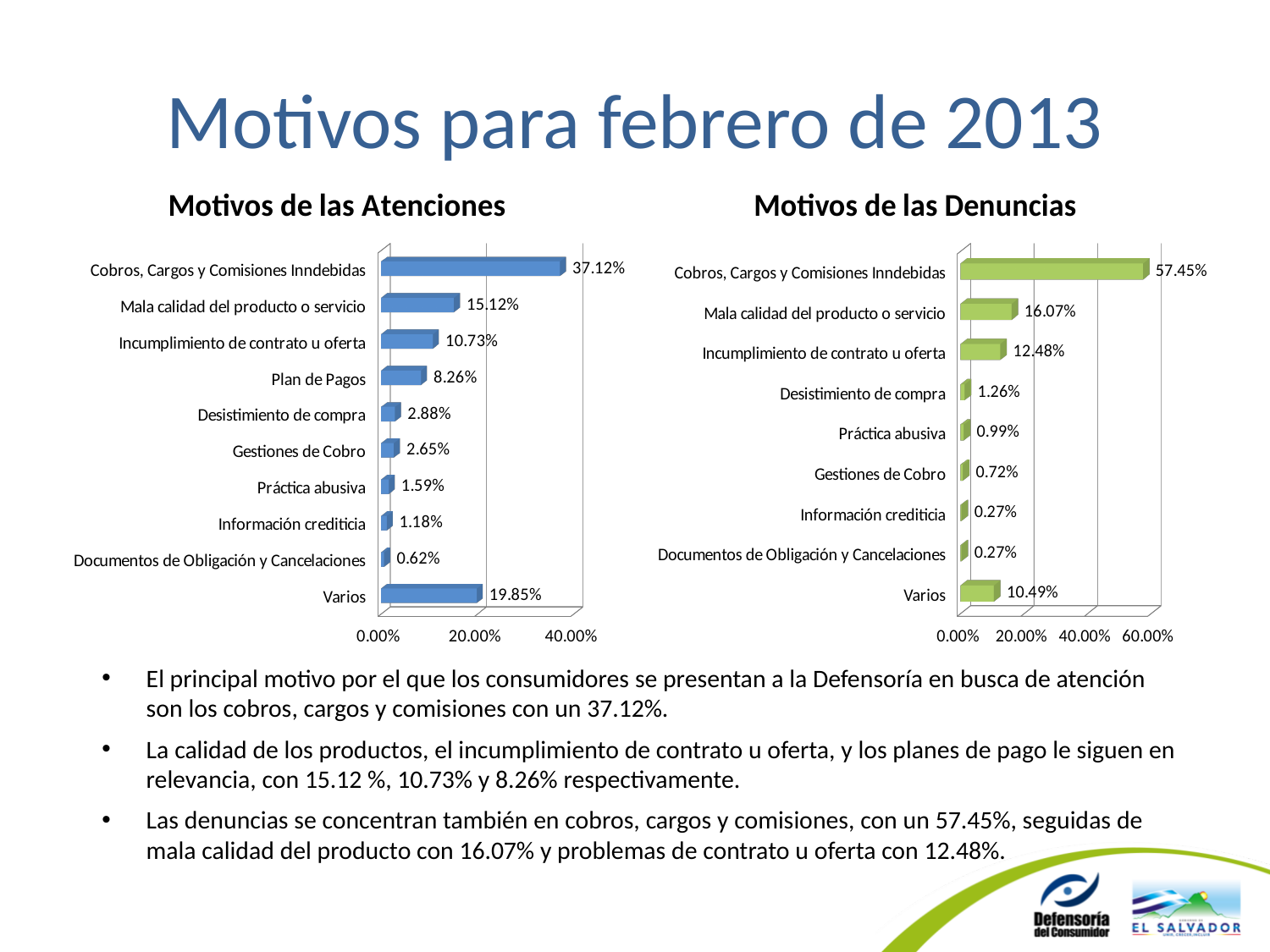
What colour are the bars in the 'Motivos de las Denuncias' chart? Green In the 'Motivos de las Denuncias' chart, is the value for Cobros, Cargos y Comisiones Inndebidas greater or less than 40.00%? greater How many categories are shown in the 'Motivos de las Atenciones' chart? 10 In the 'Motivos de las Atenciones' chart, which is larger: Plan de Pagos or Desistimiento de compra? Plan de Pagos In the 'Motivos de las Atenciones' chart, which category has the lowest value? Documentos de Obligación y Cancelaciones In the 'Motivos de las Denuncias' chart, what is the difference between Cobros, Cargos y Comisiones Inndebidas and Mala calidad del producto o servicio? 41.38% In the 'Motivos de las Denuncias' chart, what is the value for Mala calidad del producto o servicio? 16.07% In the 'Motivos de las Atenciones' chart, what is the value for Cobros, Cargos y Comisiones Inndebidas? 37.12% In the 'Motivos de las Denuncias' chart, which category has the highest value? Cobros, Cargos y Comisiones Inndebidas What type of chart is 'Motivos de las Denuncias'? Bar chart In the 'Motivos de las Atenciones' chart, what is the value for Varios? 19.85% In the 'Motivos de las Atenciones' chart, what is the difference between Mala calidad del producto o servicio and Incumplimiento de contrato u oferta? 4.39%